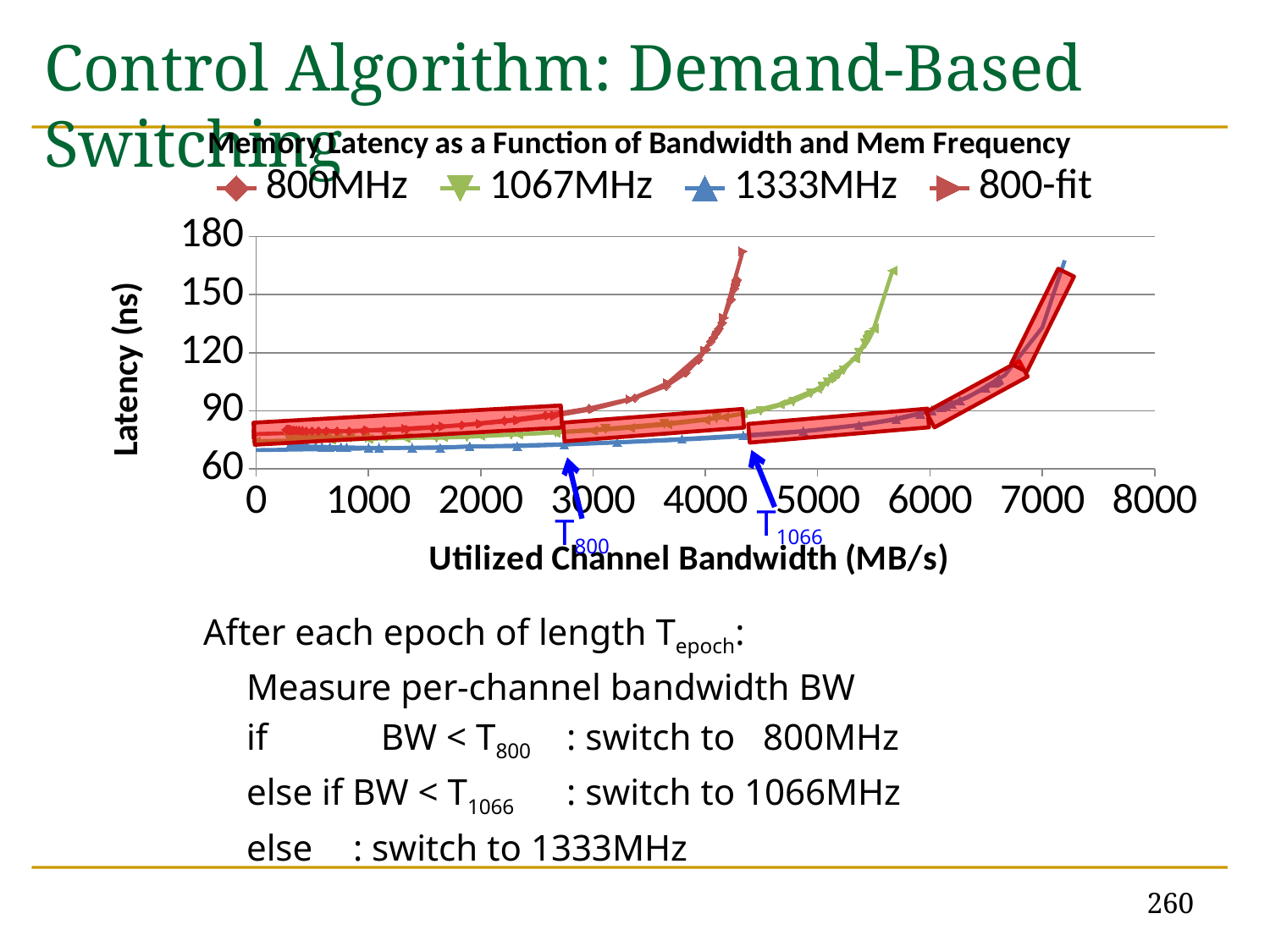
What is the highest value shown on the y axis of the chart? 180 Is the latency of the 1067MHz series at 5000 MB/s greater or less than 90 ns? greater What is the title of the chart? Memory Latency as a Function of Bandwidth and Mem Frequency What kind of chart is shown on the slide? Line chart Which series has the lowest latency at low bandwidth (around 1000 MB/s)? 1333MHz Does latency rise or fall as utilized channel bandwidth increases along the x axis? Rise Is the latency of the 1333MHz series at 2000 MB/s greater or less than 90 ns? less Which series extends to the highest utilized channel bandwidth on the x axis? 1333MHz Is the latency of the 800MHz series at 4000 MB/s greater or less than 90 ns? greater What is the label of the chart's y axis? Latency (ns) At 1000 MB/s, which series has the higher latency: 800MHz or 1333MHz? 800MHz How many series does the chart legend list? 4